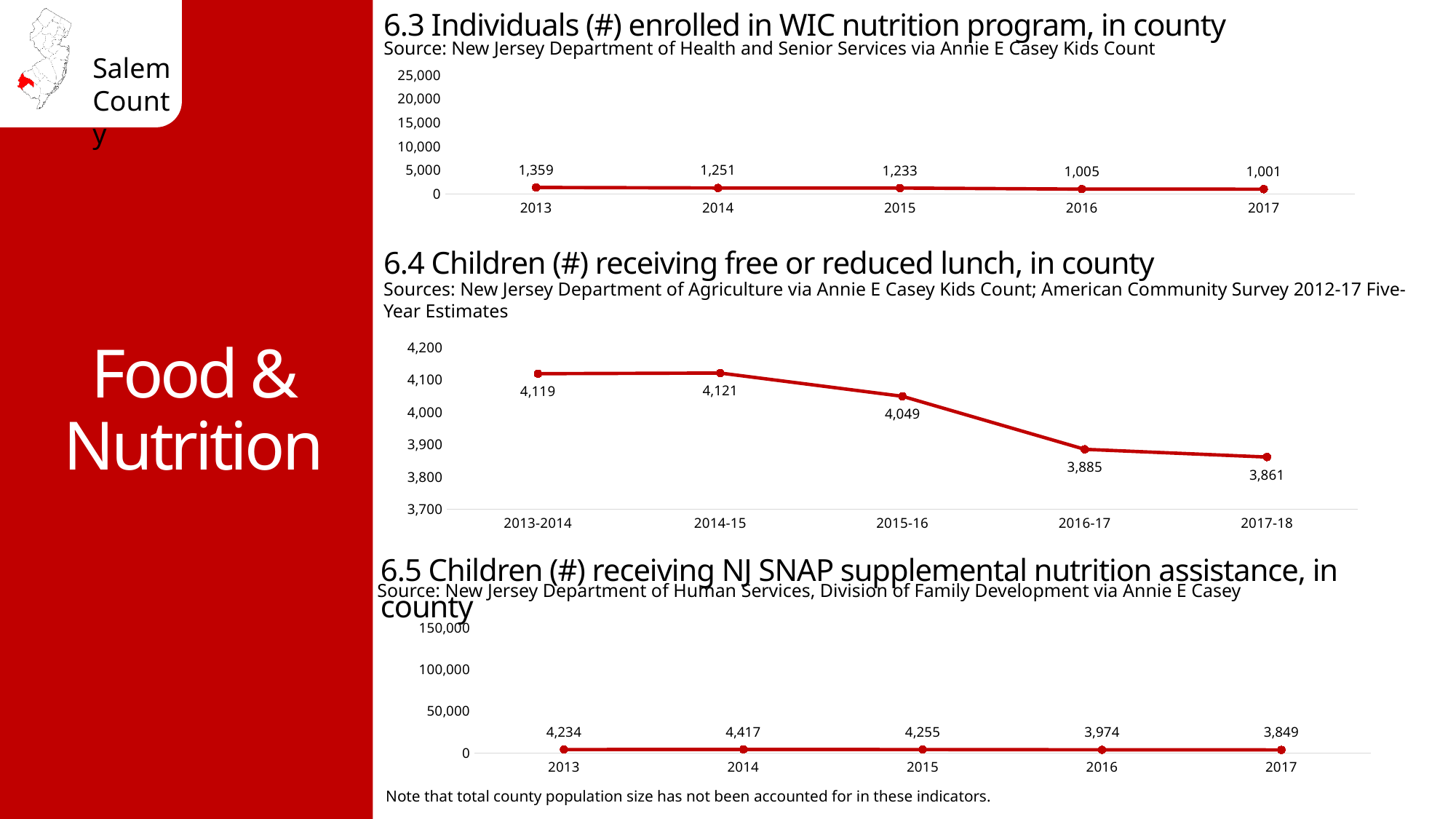
In the chart '6.4 Children (#) receiving free or reduced lunch, in county', which school year has the highest value? 2014-15 In the chart '6.5 Children (#) receiving NJ SNAP supplemental nutrition assistance, in county', which year has the lowest value? 2017 In the chart '6.3 Individuals (#) enrolled in WIC nutrition program, in county', do the values rise or fall from 2013 to 2017? fall In the chart '6.4 Children (#) receiving free or reduced lunch, in county', what is the difference between the 2014-15 and 2017-18 values? 260 In the chart '6.4 Children (#) receiving free or reduced lunch, in county', what is the value for 2015-16? 4,049 In the chart '6.3 Individuals (#) enrolled in WIC nutrition program, in county', which year has the lowest value? 2017 In the chart '6.3 Individuals (#) enrolled in WIC nutrition program, in county', what is the difference between the 2013 and 2017 values? 358 In the chart '6.3 Individuals (#) enrolled in WIC nutrition program, in county', what is the value for 2013? 1,359 In the chart '6.5 Children (#) receiving NJ SNAP supplemental nutrition assistance, in county', which is larger, the value for 2015 or the value for 2016? 2015 What kind of chart is '6.4 Children (#) receiving free or reduced lunch, in county'? line chart In the chart '6.5 Children (#) receiving NJ SNAP supplemental nutrition assistance, in county', what is the value for 2014? 4,417 In the chart '6.4 Children (#) receiving free or reduced lunch, in county', how many data points are plotted? 5